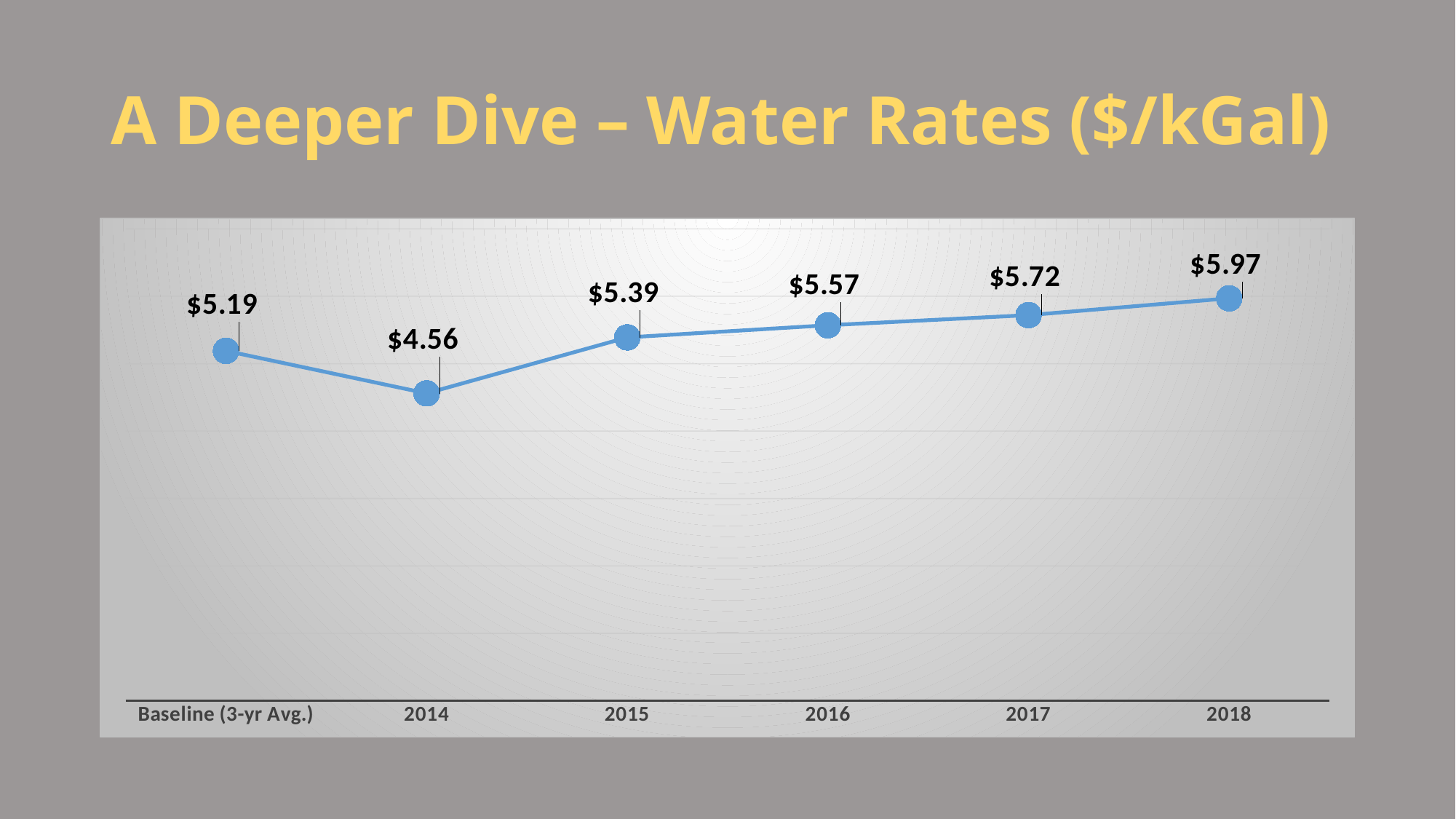
Which is larger, the Baseline (3-yr Avg.) rate or the 2015 rate? 2015 Do the water rates rise or fall from 2014 to 2018? Rise How many data points are plotted on the chart? 6 Which category has the highest water rate? 2018 What kind of chart is shown on the slide? Line chart What is the water rate for 2017? $5.72 What is the water rate for the Baseline (3-yr Avg.)? $5.19 What is the difference between the 2016 rate and the 2015 rate? $0.18 What is the title of the slide? A Deeper Dive – Water Rates ($/kGal) Which category has the lowest water rate? 2014 What is the water rate for 2014? $4.56 What is the difference between the 2018 rate and the 2014 rate? $1.41